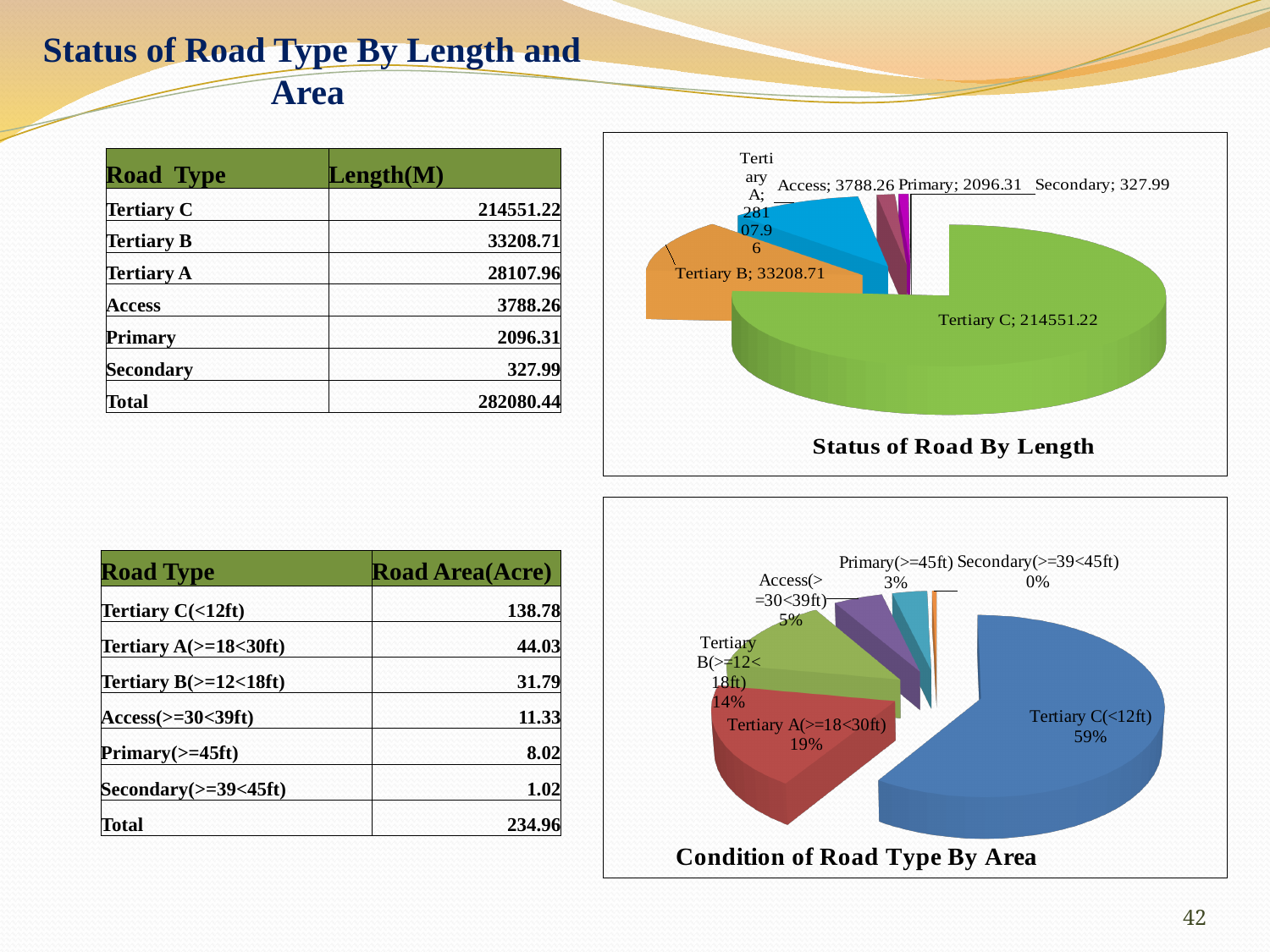
In the 'Condition of Road Type By Area' chart, what share does Tertiary C(<12ft) have? 59% In the 'Status of Road By Length' chart, which is larger, Primary or Secondary? Primary In the 'Status of Road By Length' chart, which road type has the smallest slice? Secondary In the 'Condition of Road Type By Area' chart, which road type has the smallest share? Secondary(>=39<45ft) What is the title of the bottom chart on the slide? Condition of Road Type By Area How many slices does the 'Status of Road By Length' chart have? 6 What kind of chart is 'Status of Road By Length'? Pie chart In the 'Condition of Road Type By Area' chart, what share does Tertiary A(>=18<30ft) have? 19% In the 'Status of Road By Length' chart, what is the value for Tertiary C? 214551.22 In the 'Status of Road By Length' chart, what is the difference between the values for Tertiary B and Tertiary A? 5100.75 In the 'Status of Road By Length' chart, what is the value for Access? 3788.26 In the 'Status of Road By Length' chart, which road type has the largest slice? Tertiary C